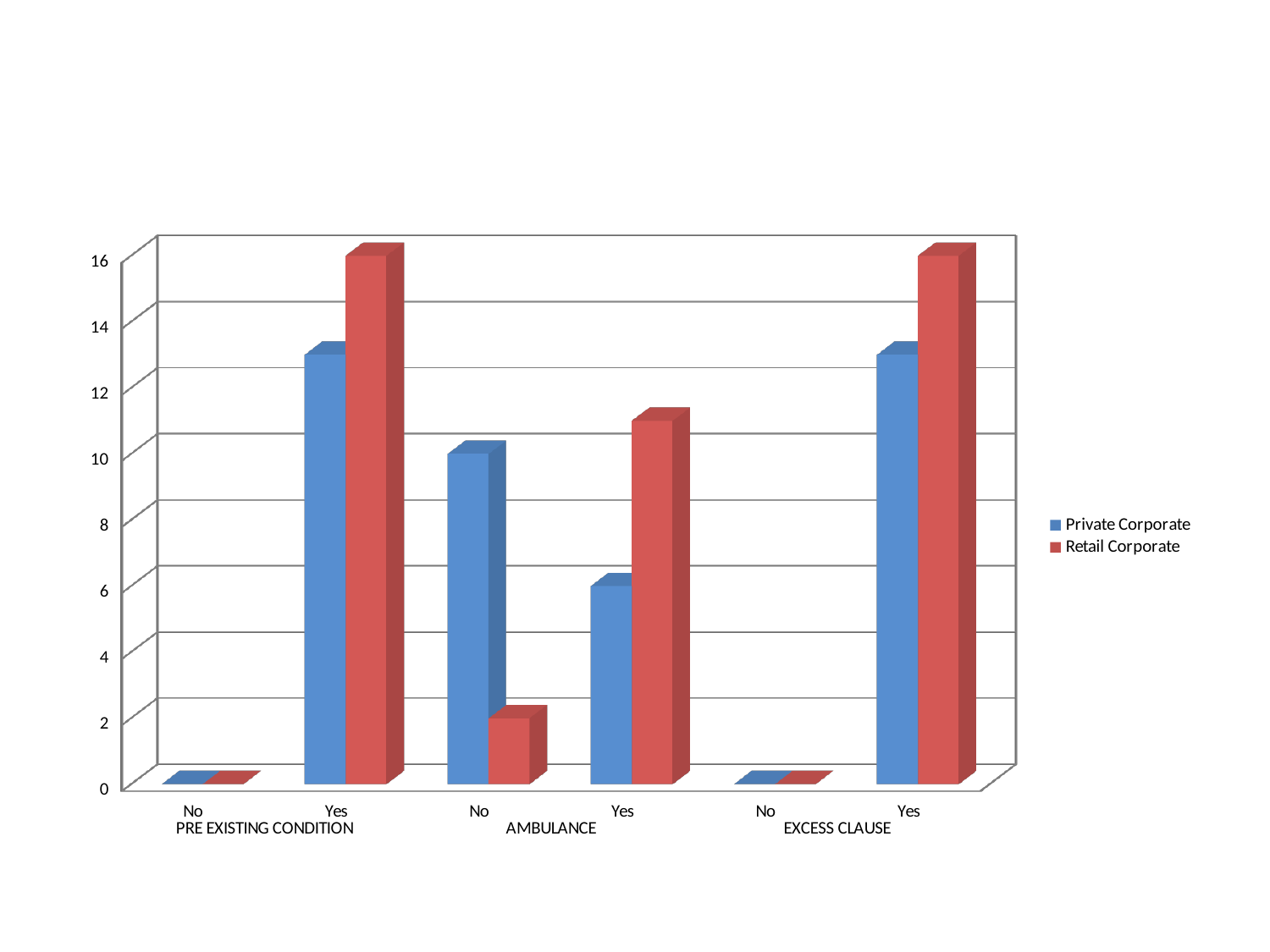
How many series does the legend list? 2 Which colour represents Retail Corporate in the chart? red Is the Private Corporate value for Yes under PRE EXISTING CONDITION greater or less than 12? greater Is the Private Corporate value for Yes under EXCESS CLAUSE greater or less than 14? less Which is larger for No under AMBULANCE, Private Corporate or Retail Corporate? Private Corporate Which is larger for Yes under AMBULANCE, Private Corporate or Retail Corporate? Retail Corporate What type of chart is shown on the slide? bar chart Which series has the highest bar in the chart? Retail Corporate Is the Retail Corporate value for No under AMBULANCE greater or less than 4? less What are the two series named in the legend? Private Corporate and Retail Corporate How many categories are shown along the x axis? 6